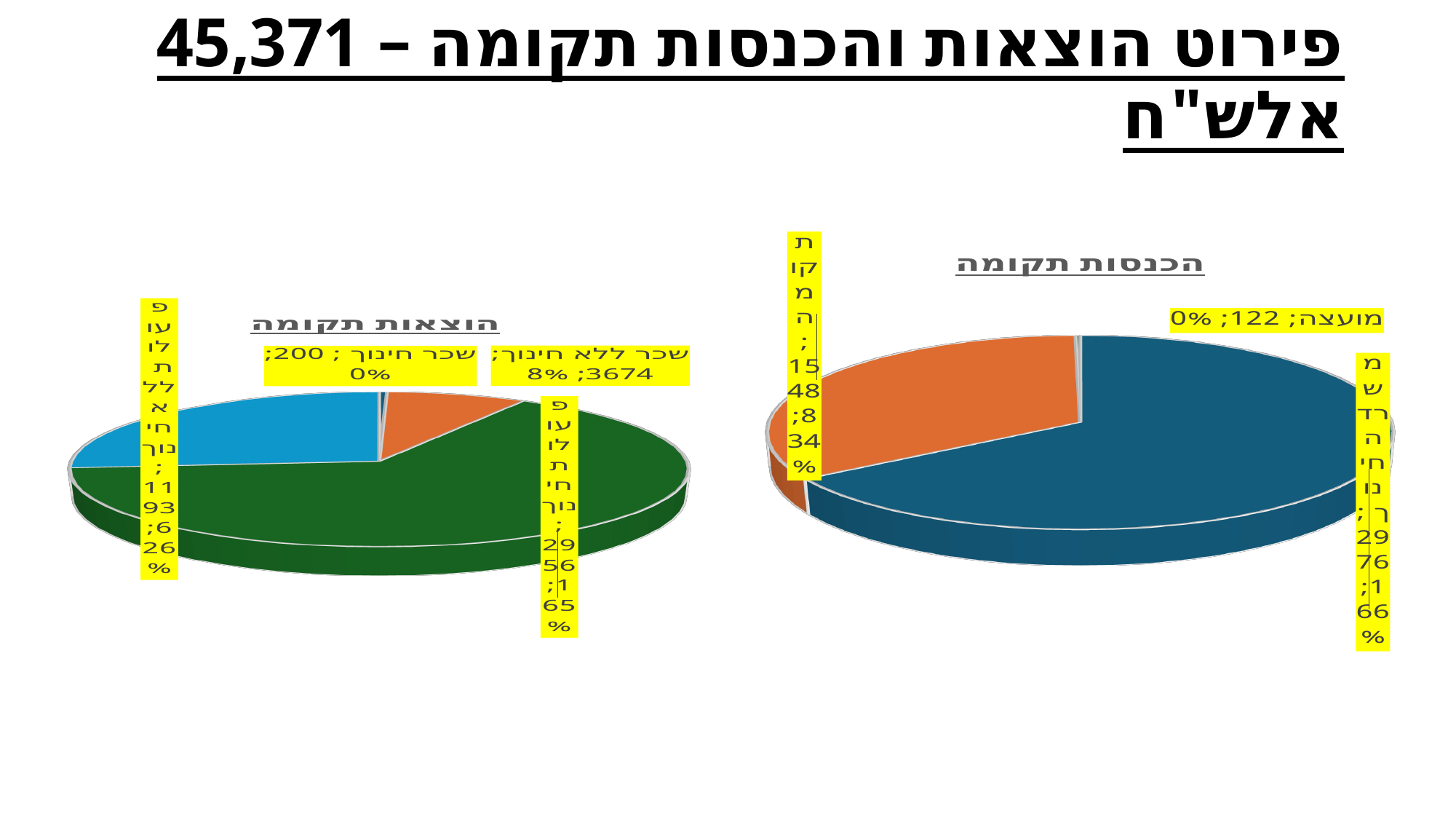
In the "הוצאות תקומה" chart on the left, how many slices are there? 4 In the "הוצאות תקומה" chart on the left, which category is the smallest? שכר חינוך In the "הוצאות תקומה" chart on the left, what is the value for שכר ללא חינוך? 3674 In the "הוצאות תקומה" chart on the left, what is the value for פעולות חינוך? 29561 In the "הוצאות תקומה" chart on the left, what is the difference between the values for פעולות חינוך and פעולות ללא חינוך? 17625 In the "הכנסות תקומה" chart on the right, what is the value for משרד החינוך? 29761 In the "הכנסות תקומה" chart on the right, which category is the largest? משרד החינוך In the "הכנסות תקומה" chart on the right, what share of the pie does תקומה have? 34% In the "הוצאות תקומה" chart on the left, what share of the pie does פעולות ללא חינוך have? 26% What kind of chart is the "הוצאות תקומה" chart on the left? Pie chart In the "הכנסות תקומה" chart on the right, what is the value for מועצה? 122 In the "הכנסות תקומה" chart on the right, how many slices are there? 3